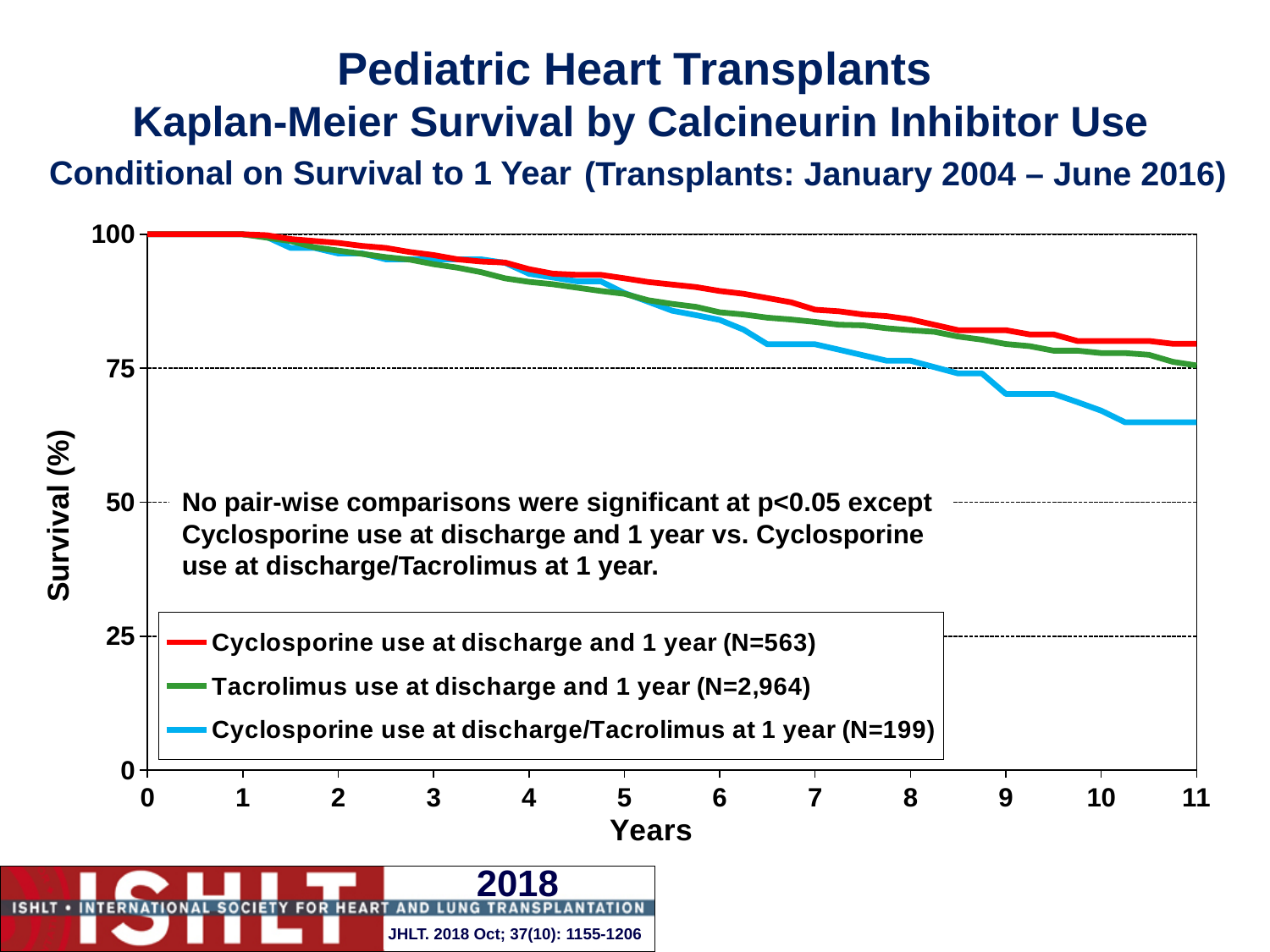
At 11 years, which series has the lowest survival? Cyclosporine use at discharge/Tacrolimus at 1 year Is the survival value for Cyclosporine use at discharge/Tacrolimus at 1 year at 11 years greater or less than 75? less What is the N for the Cyclosporine use at discharge and 1 year series? N=563 At 11 years, which series has the highest survival? Cyclosporine use at discharge and 1 year How many series does the legend list? 3 Do the survival curves rise or fall as years increase? Fall At 10 years, which is higher: survival for Tacrolimus use at discharge and 1 year or for Cyclosporine use at discharge/Tacrolimus at 1 year? Tacrolimus use at discharge and 1 year Is the survival value for Cyclosporine use at discharge and 1 year at 11 years greater or less than 75? greater What is the N for the Tacrolimus use at discharge and 1 year series? N=2,964 What is the N for the Cyclosporine use at discharge/Tacrolimus at 1 year series? N=199 What kind of chart is shown on the slide? Line chart Is the survival value for Tacrolimus use at discharge and 1 year at 5 years greater or less than 75? greater